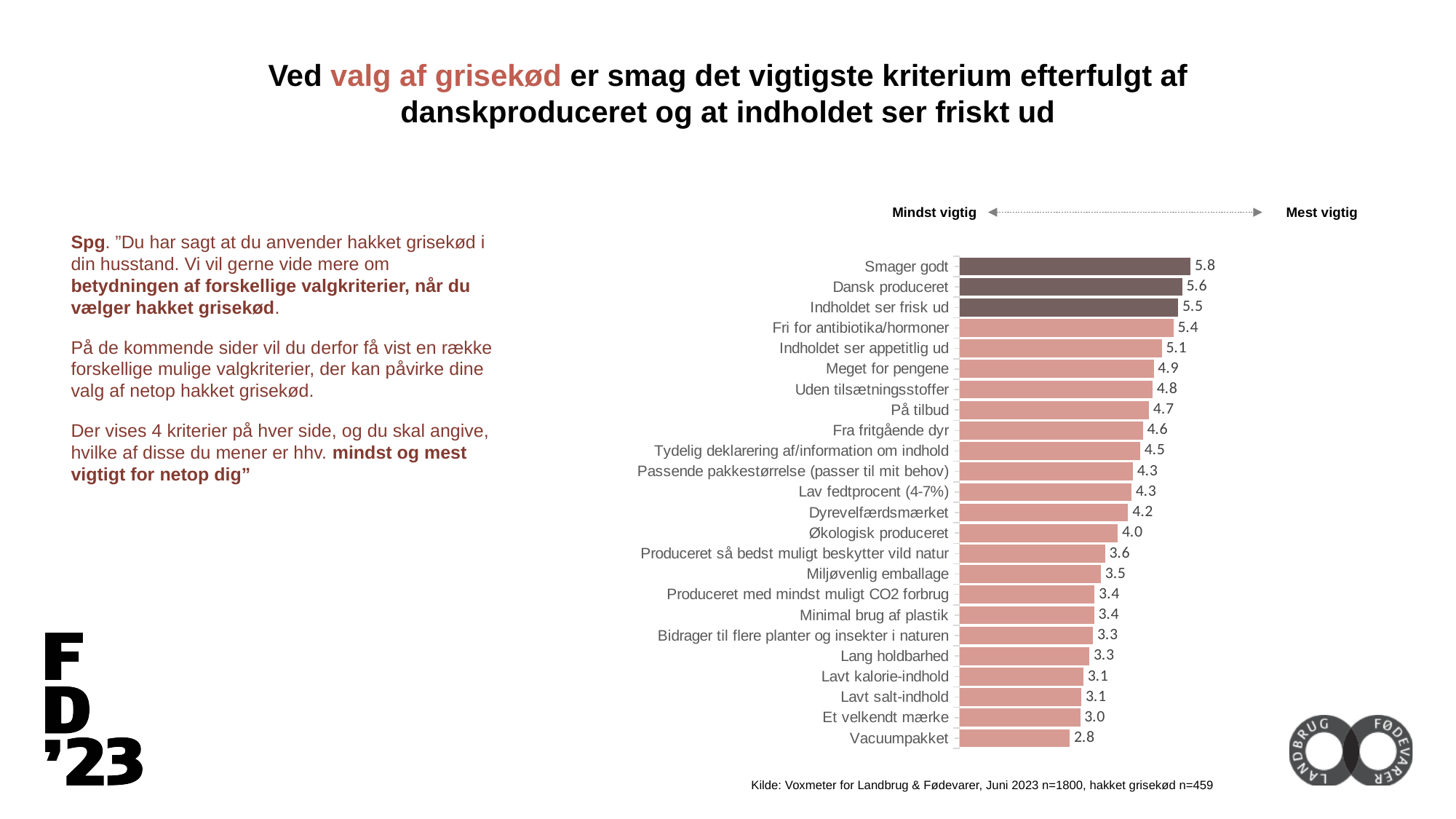
Which has a larger value, "Miljøvenlig emballage" or "Et velkendt mærke"? Miljøvenlig emballage What is the value for "Lavt salt-indhold"? 3.1 How many criteria are plotted in the chart? 24 What is the difference between the values for "Smager godt" and "Vacuumpakket"? 3.0 Which has a larger value, "Fri for antibiotika/hormoner" or "Meget for pengene"? Fri for antibiotika/hormoner What is the value for "Smager godt"? 5.8 What label appears at the right end of the arrow above the chart? Mest vigtig What kind of chart is shown on the slide? bar chart Which criterion has the lowest value? Vacuumpakket Which criterion has the highest value? Smager godt What is the value for "Økologisk produceret"? 4.0 What is the difference between the values for "Dansk produceret" and "Dyrevelfærdsmærket"? 1.4